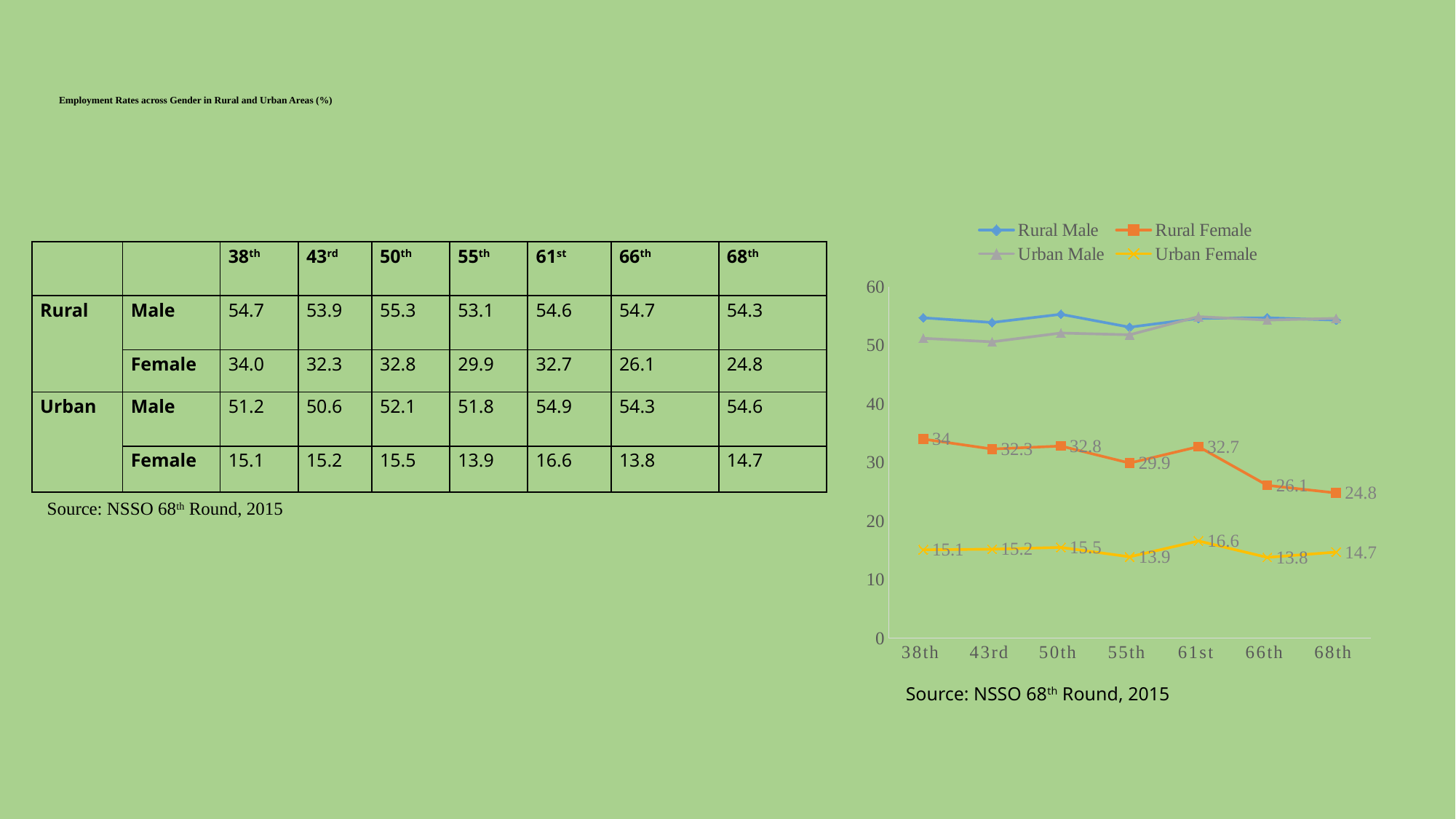
What kind of chart is shown on the right of the slide? line chart What colour is the Rural Female line in the chart? orange In the chart, which round has the lowest Rural Female value? 68th In the chart, is the Rural Female value larger for the 55th round or the 61st round? 61st How many series does the chart's legend list? 4 In the chart, is the Rural Male value for the 38th round greater or less than 50? greater In the chart, which round has the highest Urban Female value? 61st How many NSSO rounds are plotted along the x axis of the chart? 7 In the chart, what is the difference between the Rural Female value for the 38th round and the 68th round? 9.2 In the chart, what is the Urban Female value for the 61st round? 16.6 In the chart, does the Rural Female line overall rise or fall from the 38th round to the 68th round? fall In the chart, what is the Rural Female value for the 68th round? 24.8